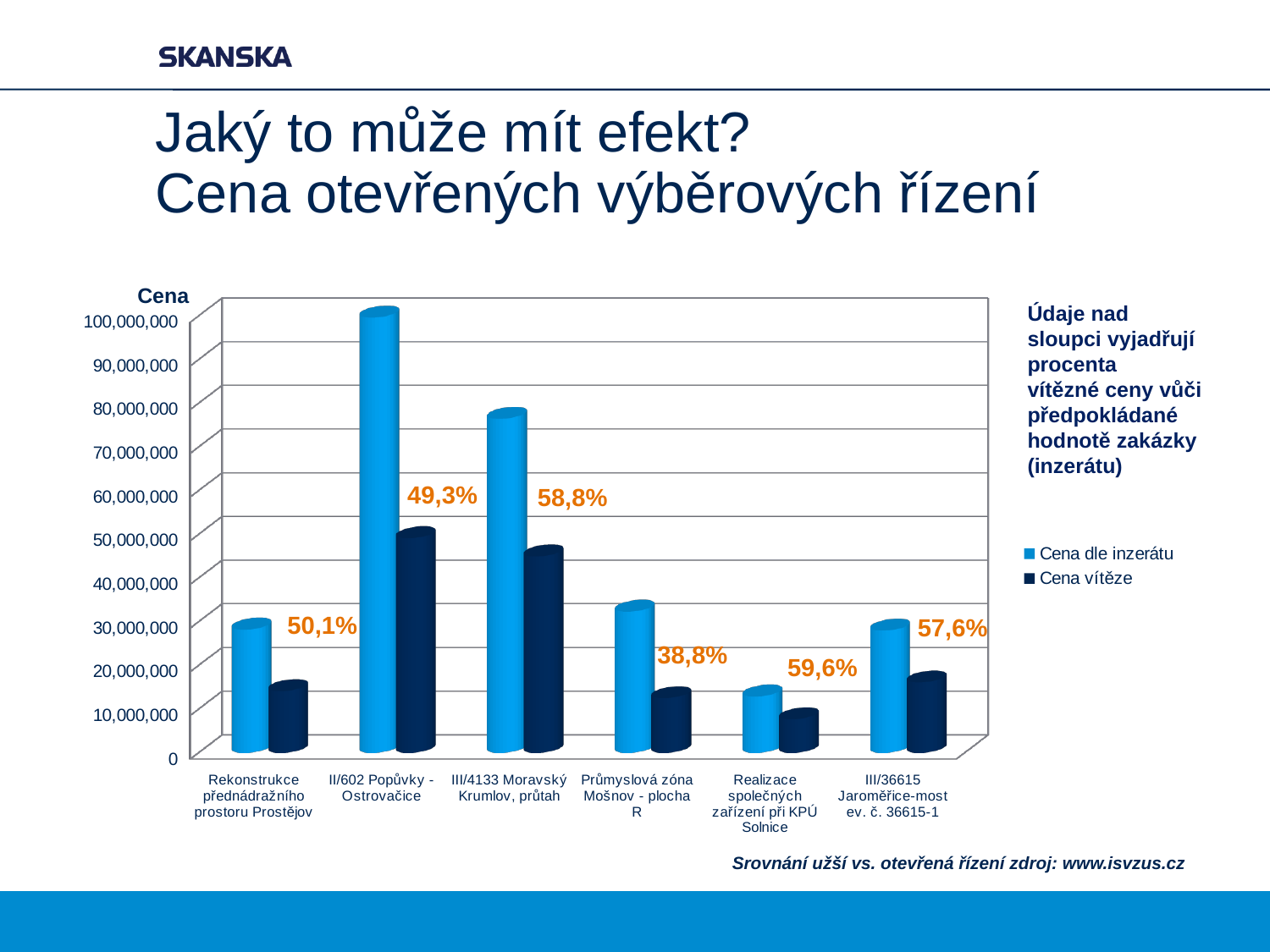
What is the difference between the percentage labels for III/4133 Moravský Krumlov, průtah and Průmyslová zóna Mošnov - plocha R? 20,0 percentage points What kind of chart is shown on the slide? bar chart Which project has the lowest percentage label shown above its bars? Průmyslová zóna Mošnov - plocha R How many series does the chart legend list? 2 Is the Cena vítěze value for Rekonstrukce přednádražního prostoru Prostějov greater or less than 20,000,000? less What percentage label is shown for Průmyslová zóna Mošnov - plocha R? 38,8% What percentage label is shown for II/602 Popůvky - Ostrovačice? 49,3% Which project has the highest Cena dle inzerátu bar? II/602 Popůvky - Ostrovačice What percentage label is shown for III/36615 Jaroměřice-most ev. č. 36615-1? 57,6% Which project has the highest percentage label shown above its bars? Realizace společných zařízení při KPÚ Solnice Is the Cena dle inzerátu value for III/4133 Moravský Krumlov, průtah greater or less than 70,000,000? greater How many project categories are shown on the x axis of the chart? 6